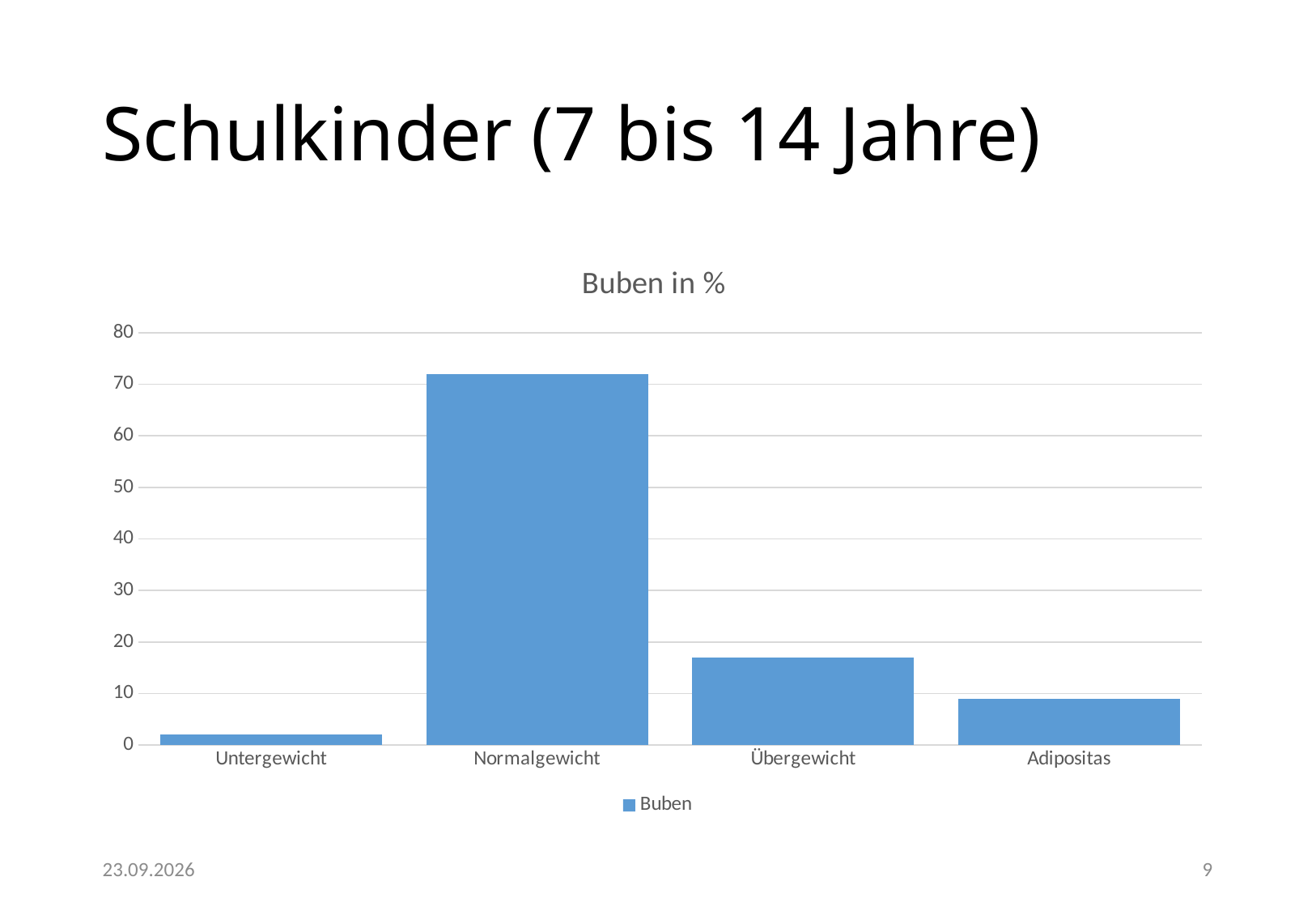
How many categories are shown on the x axis of the chart? 4 What is the name of the series shown in the legend? Buben Which is larger, the value for Übergewicht or the value for Adipositas? Übergewicht Is the value for Adipositas greater or less than 10? less What is the title of the chart? Buben in % Is the value for Übergewicht greater or less than 20? less Is the value for Untergewicht greater or less than 10? less Which category has the lowest value? Untergewicht What kind of chart is shown on the slide? bar chart Which category has the highest value? Normalgewicht How many series does the legend list? 1